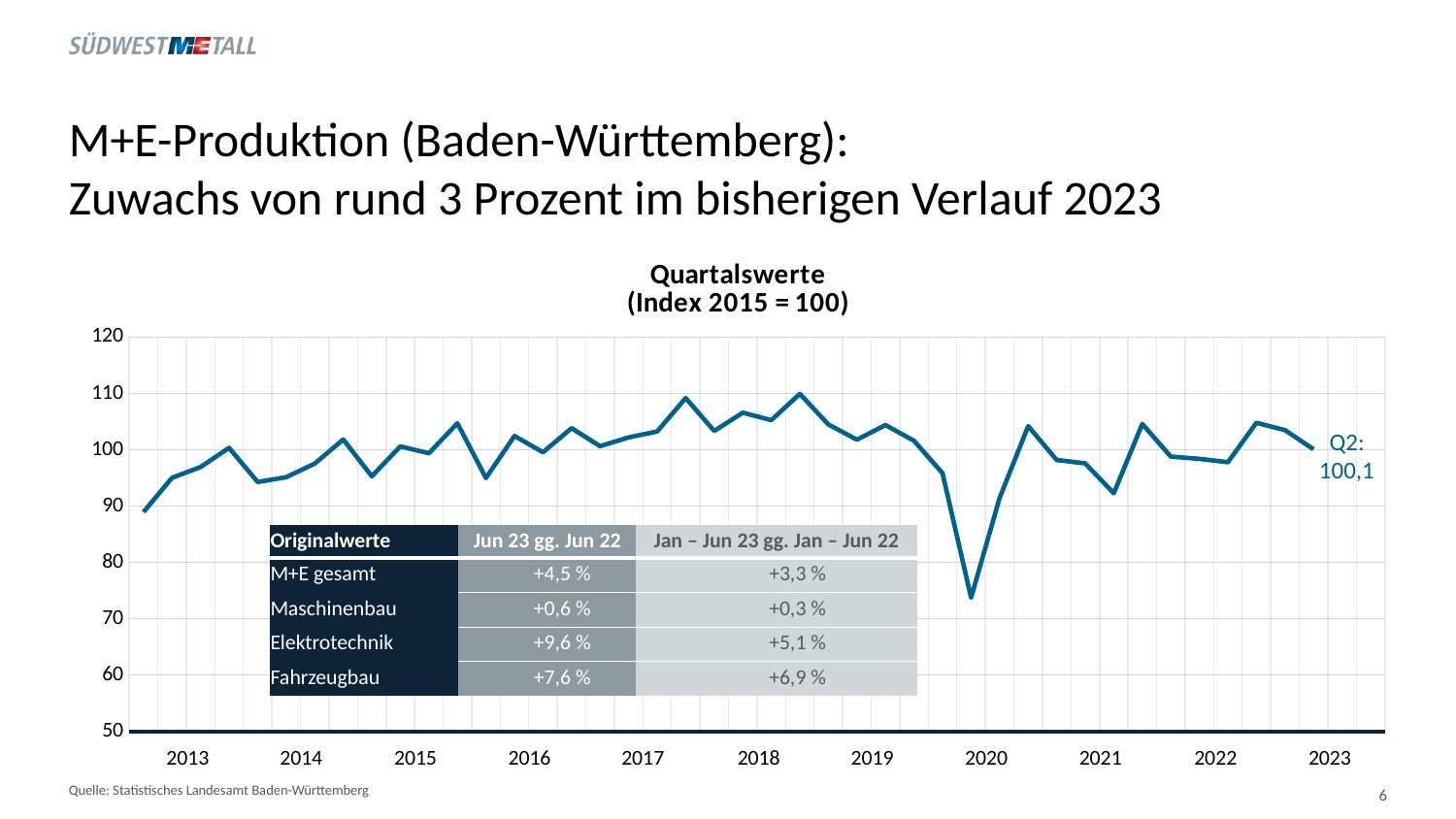
What is the title of the chart? Quartalswerte (Index 2015 = 100) What kind of chart is shown on the slide? line chart Is the first plotted value in 2013 greater or less than 100? less In which year does the line reach its lowest point? 2020 What is the base year of the index used on the y axis? 2015 Is the labelled Q2 2023 value greater or less than 100? greater Is the highest value of the line, reached in 2018, greater or less than 105? greater How many year labels are shown on the x axis? 11 Do the values generally rise or fall from 2013 to 2018? rise Which is higher: the first value in 2013 or the lowest value in 2020? the first value in 2013 What value is labelled for Q2 2023 at the end of the line? 100,1